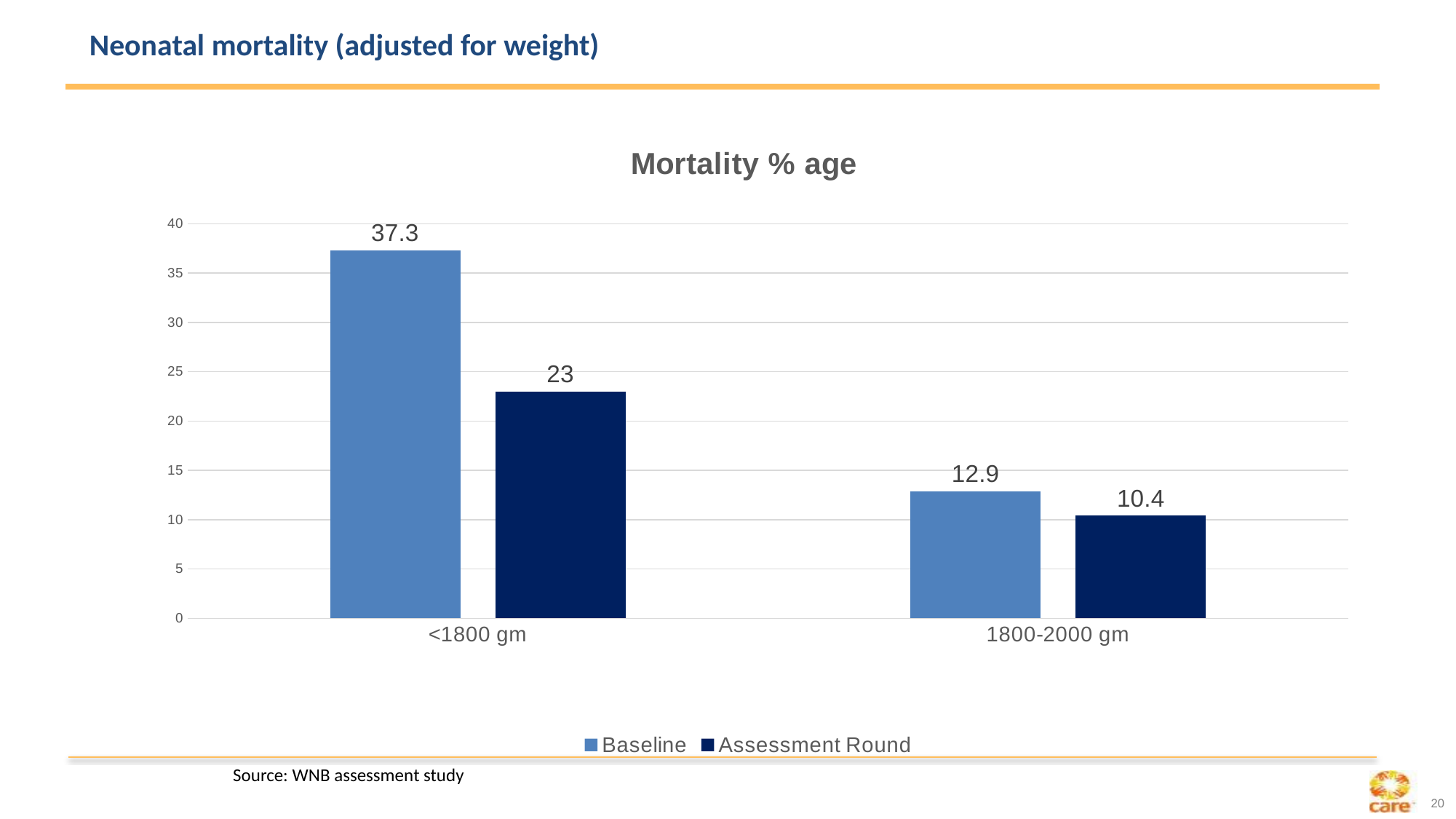
What is the Baseline mortality % for the <1800 gm category? 37.3 What is the Assessment Round mortality % for the <1800 gm category? 23 Which category has the highest Baseline mortality %? <1800 gm What is the difference between the Baseline and Assessment Round values for the <1800 gm category? 14.3 How many series does the legend list? 2 What is the Baseline mortality % for the 1800-2000 gm category? 12.9 What kind of chart is shown on the slide? Bar chart How many weight categories are shown on the x axis? 2 Which is larger for the 1800-2000 gm category, the Baseline or the Assessment Round value? Baseline Which category has the lowest Assessment Round mortality %? 1800-2000 gm What is the difference between the Baseline and Assessment Round values for the 1800-2000 gm category? 2.5 What is the Assessment Round mortality % for the 1800-2000 gm category? 10.4